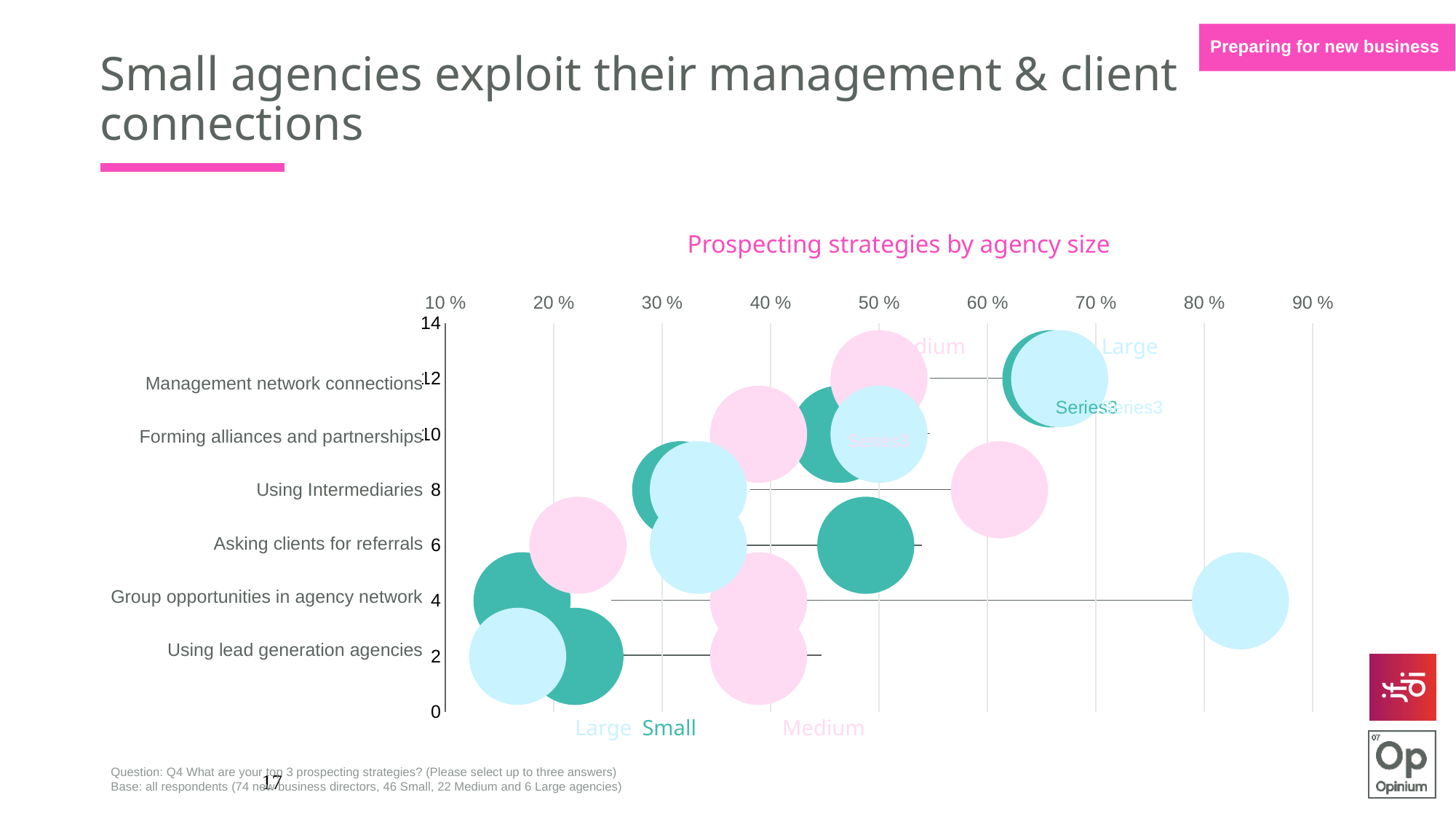
Which agency size is shown in pink in the chart? Medium How many prospecting strategies are listed on the vertical axis of the chart? 6 For 'Group opportunities in agency network', which is larger: the value for Large agencies or for Small agencies? Large Is the value for Medium agencies for 'Asking clients for referrals' greater or less than 30%? less Which prospecting strategy has the highest value for Large agencies? Group opportunities in agency network Is the value for Large agencies for 'Group opportunities in agency network' greater or less than 70%? greater What is the title of the chart? Prospecting strategies by agency size Is the value for Small agencies for 'Management network connections' greater or less than 60%? greater For 'Using Intermediaries', which is larger: the value for Medium agencies or for Small agencies? Medium How many series does the chart legend list? 3 What type of chart is shown on the slide? Bubble chart